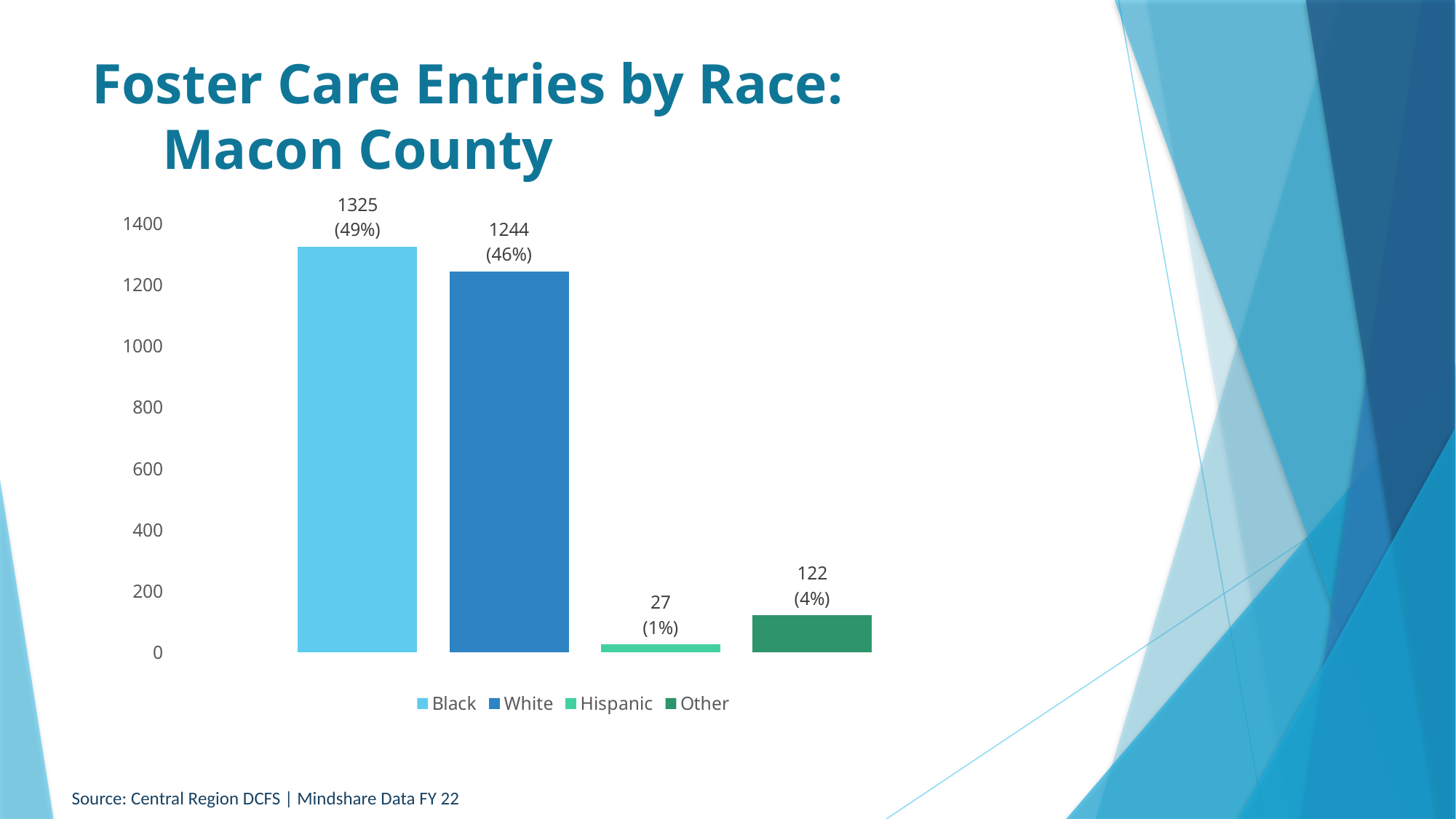
What is the total of the foster care entries for Black and White children combined? 2569 Which race category has the highest number of foster care entries? Black What is the difference between the foster care entries for Black and White children? 81 Which race category has the lowest number of foster care entries? Hispanic What is the number of foster care entries for White children in Macon County? 1244 What percentage of foster care entries is shown for Hispanic children? 1% What is the number of foster care entries for the Other category? 122 Is the value for White greater or less than 1000? greater Which has more foster care entries, Other or Hispanic? Other What kind of chart is shown on the slide? Bar chart What is the number of foster care entries for Black children in Macon County? 1325 How many race categories are plotted in the chart? 4